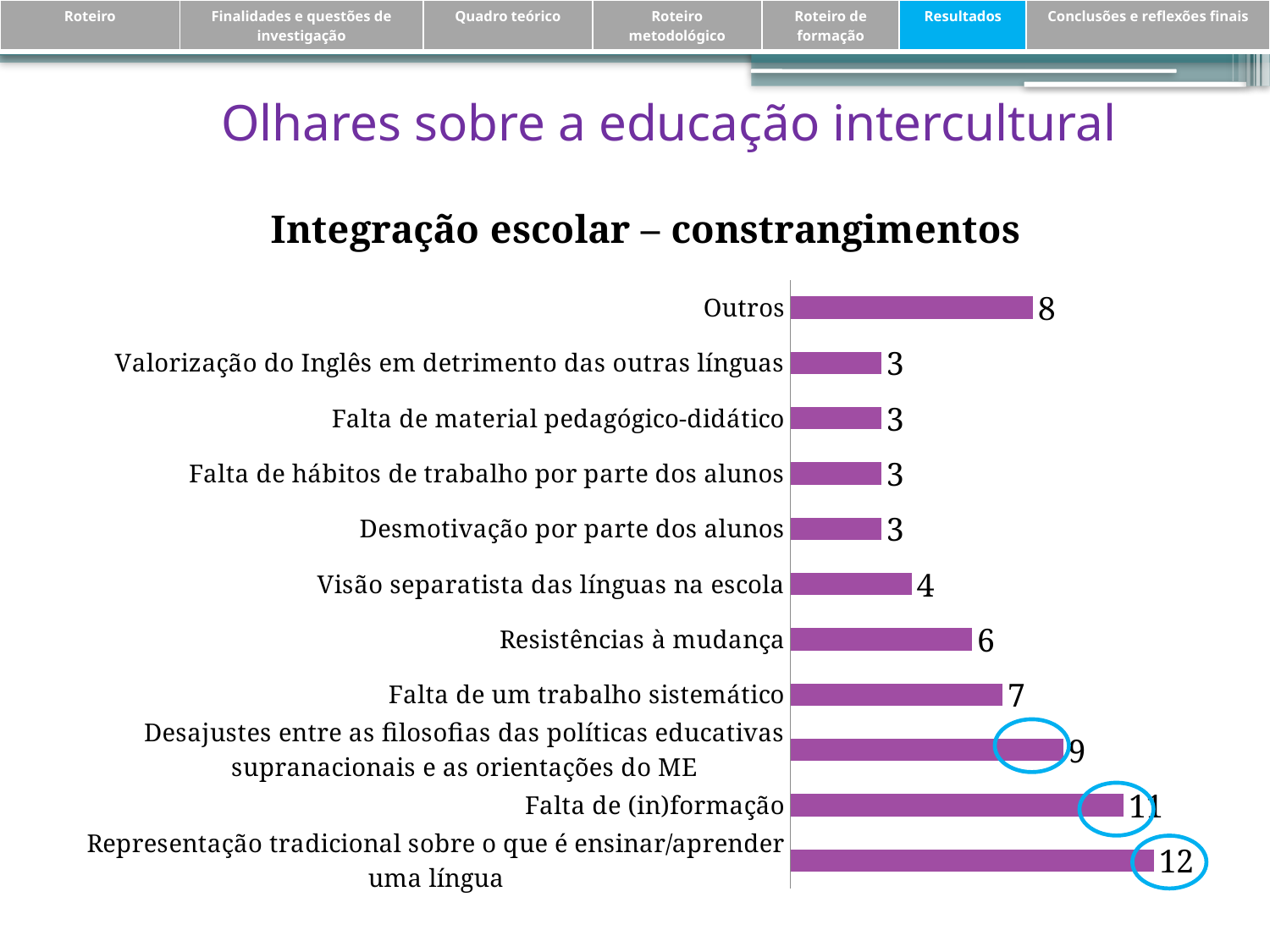
What is the difference between the values for "Representação tradicional sobre o que é ensinar/aprender uma língua" and "Falta de um trabalho sistemático"? 5 Which is larger, the value for "Outros" or the value for "Desajustes entre as filosofias das políticas educativas supranacionais e as orientações do ME"? Desajustes entre as filosofias das políticas educativas supranacionais e as orientações do ME What is the value for "Falta de (in)formação"? 11 What is the value for "Outros"? 8 How many categories have a value of 3? 4 What kind of chart is shown on the slide? Bar chart What is the title of the chart? Integração escolar – constrangimentos What is the value for "Visão separatista das línguas na escola"? 4 What is the difference between the values for "Falta de (in)formação" and "Resistências à mudança"? 5 Which category has the highest value? Representação tradicional sobre o que é ensinar/aprender uma língua How many categories are shown in the chart? 11 What is the value for "Resistências à mudança"? 6